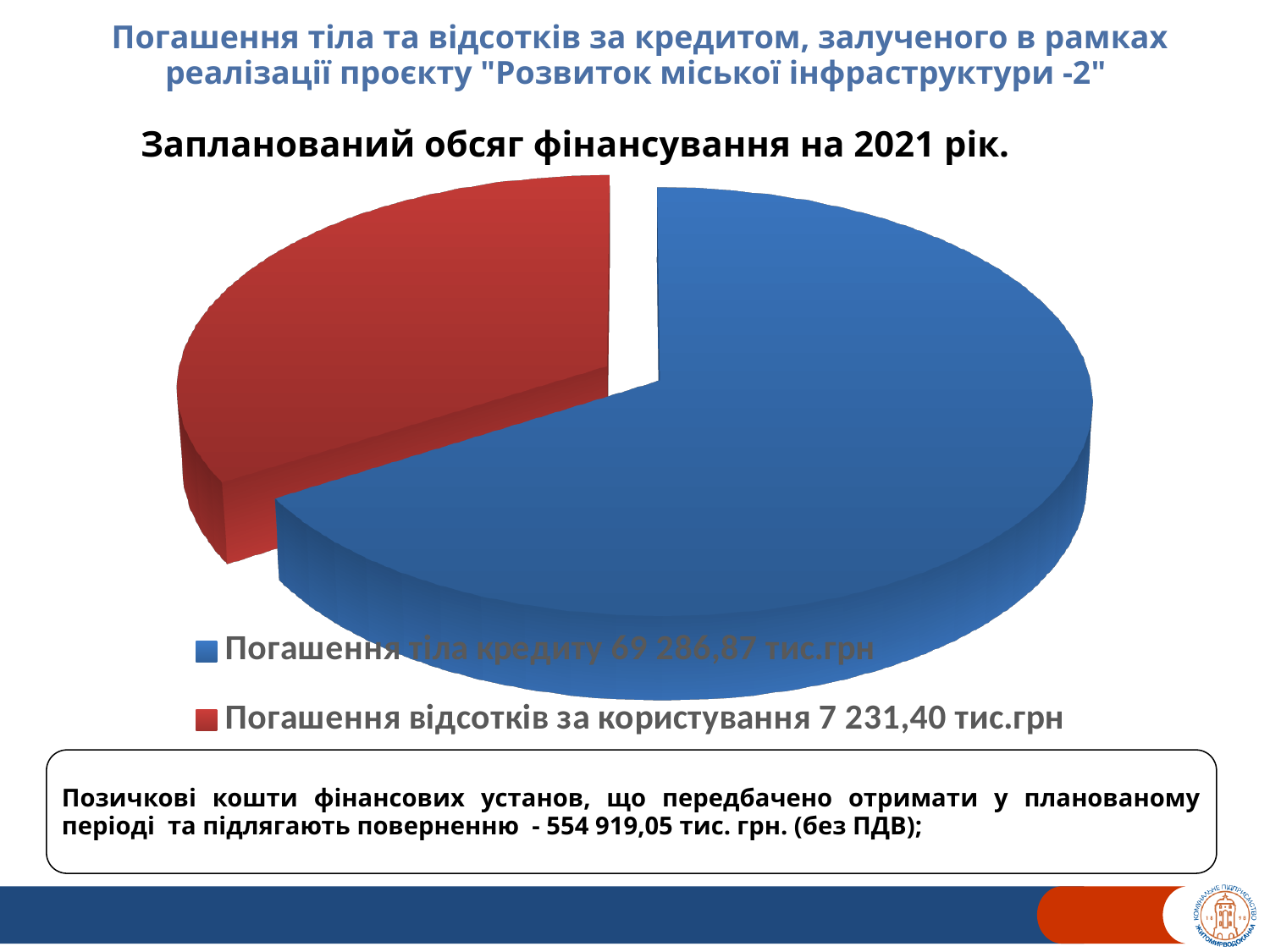
How many slices does the pie chart have? 2 What kind of chart is shown on the slide? pie chart What is the difference between the value for "Погашення тіла кредиту" and the value for "Погашення відсотків за користування"? 62 055,47 тис.грн Which category has the largest slice in the pie chart? Погашення тіла кредиту Which category has the smallest slice in the pie chart? Погашення відсотків за користування What is the total of the two values shown in the pie chart legend? 76 518,27 тис.грн How many entries does the legend of the pie chart list? 2 What is the title of the pie chart? Запланований обсяг фінансування на 2021 рік. What value is given for "Погашення відсотків за користування" in the pie chart legend? 7 231,40 тис.грн Which is larger: the value for "Погашення тіла кредиту" or for "Погашення відсотків за користування"? Погашення тіла кредиту What colour is the slice for "Погашення відсотків за користування"? red What value is given for "Погашення тіла кредиту" in the pie chart legend? 69 286,87 тис.грн